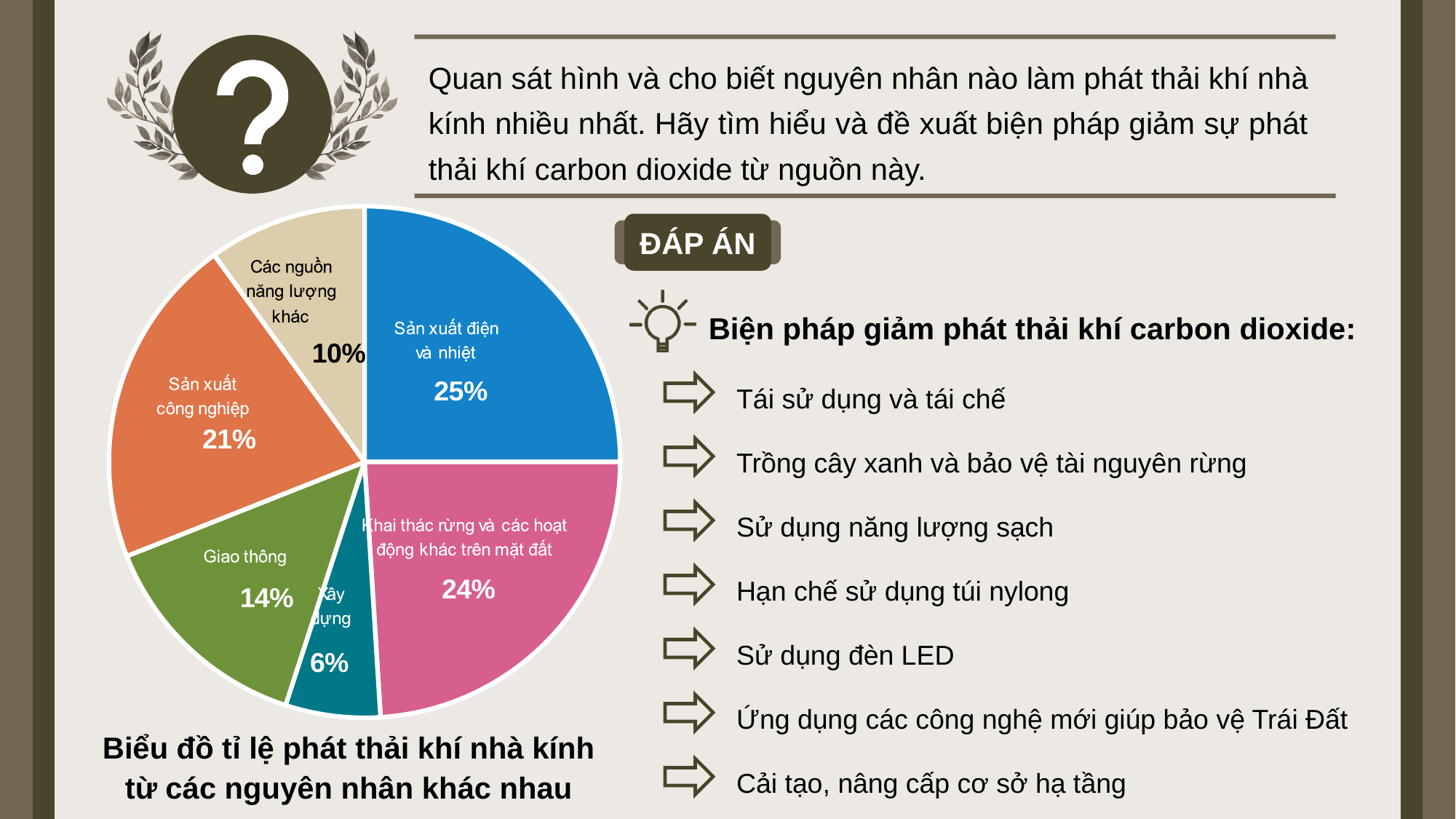
Which category has the smallest share of the pie? Xây dựng What percentage is shown for "Xây dựng"? 6% What is the title of the chart? Biểu đồ tỉ lệ phát thải khí nhà kính từ các nguyên nhân khác nhau How many slices does the pie chart have? 6 What percentage of greenhouse gas emissions comes from "Sản xuất điện và nhiệt"? 25% What is the difference between the shares of "Sản xuất công nghiệp" and "Các nguồn năng lượng khác"? 11% What percentage is shown for "Sản xuất công nghiệp"? 21% What is the combined share of "Sản xuất điện và nhiệt" and "Khai thác rừng và các hoạt động khác trên mặt đất"? 49% Which category has the largest share of the pie? Sản xuất điện và nhiệt What kind of chart is shown on the slide? Pie chart Which is larger: the share for "Giao thông" or the share for "Các nguồn năng lượng khác"? Giao thông What percentage is shown for "Giao thông"? 14%